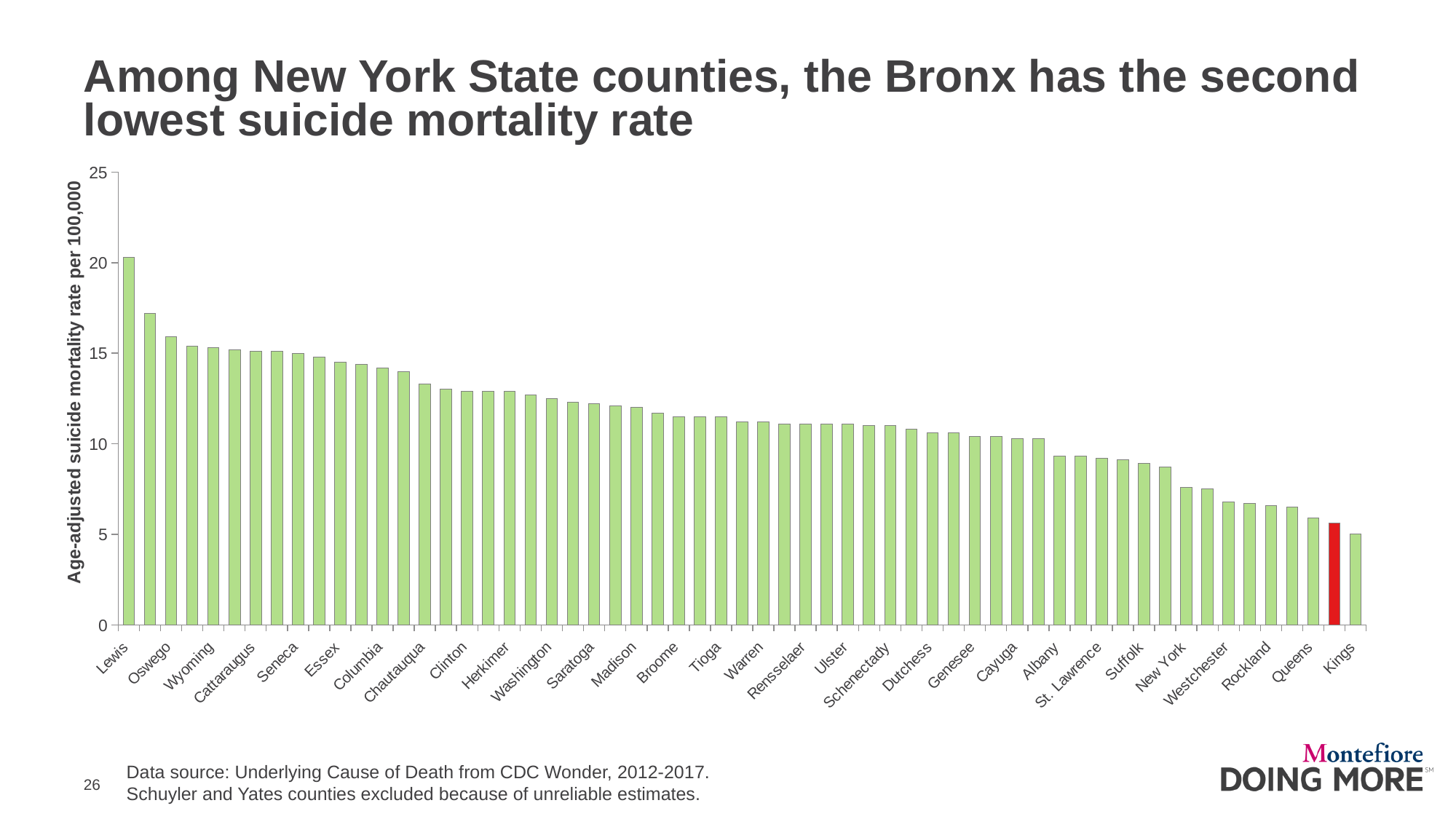
Is the value for New York greater or less than 10? less Which county has the lowest age-adjusted suicide mortality rate? Kings Which county has the highest age-adjusted suicide mortality rate? Lewis Which has the larger value, Lewis or Oswego? Lewis What kind of chart is shown on the slide? bar chart Is the value for Kings greater or less than 10? less Is the value for Lewis greater or less than 15? greater Do the values rise or fall moving from left to right along the x axis? fall Which has the larger value, Queens or Kings? Queens What colour is the bar for the Bronx, the second lowest bar? red